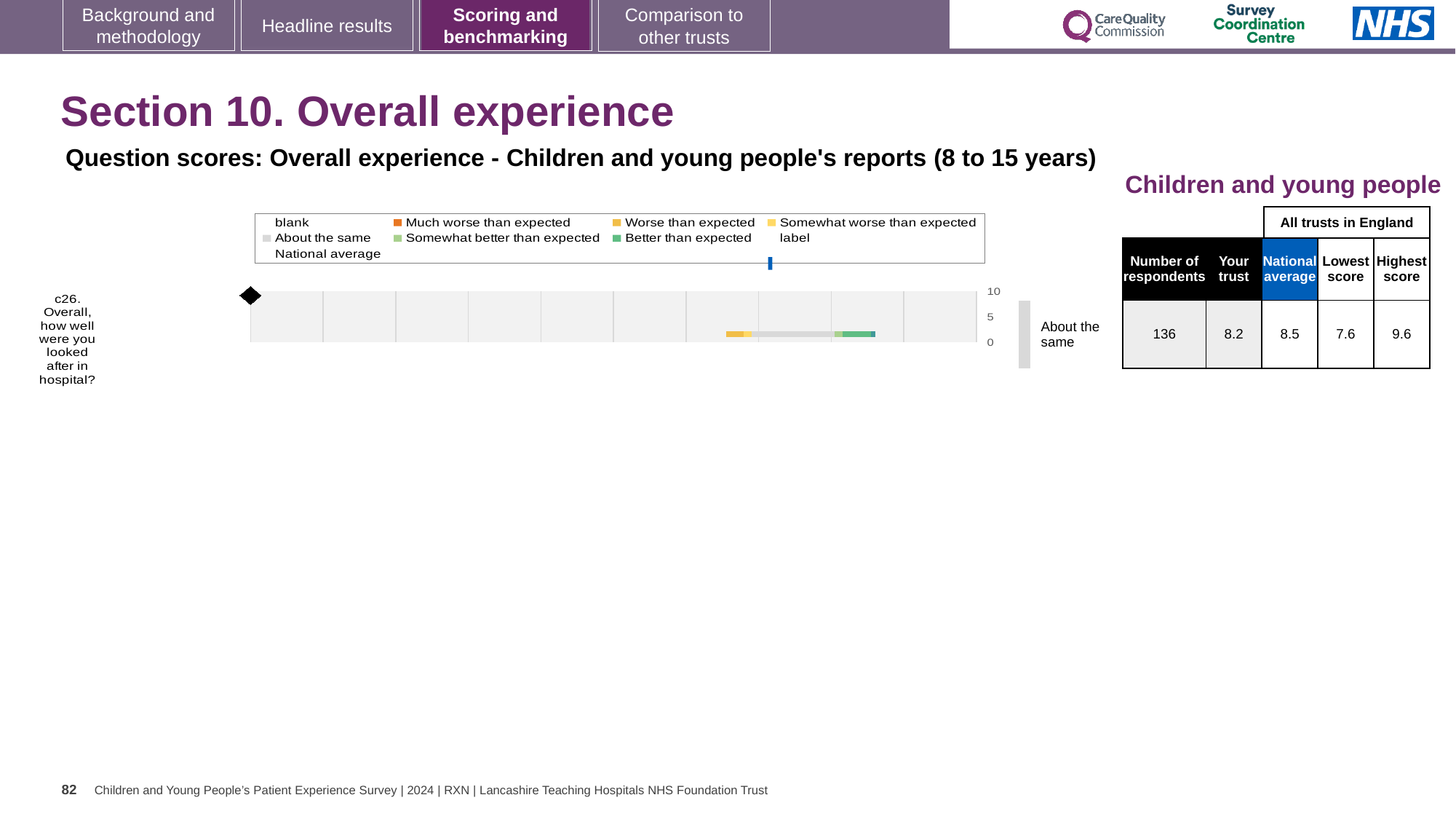
What is the maximum value shown on the chart's score axis? 10 What is the difference between the national average and the 'Your trust' score for question c26? 0.3 What kind of chart is used to show the score for question c26? bar chart What is the difference between the highest and lowest scores for question c26? 2.0 How many respondents answered question c26? 136 What benchmark category is shown next to the bar for question c26? About the same Which is larger for question c26: the 'Your trust' score or the national average? National average How many survey questions are plotted in the chart? 1 What is the 'Your trust' score for question c26, 'Overall, how well were you looked after in hospital?' 8.2 What is the highest score among all trusts in England for question c26? 9.6 What is the lowest score among all trusts in England for question c26? 7.6 What is the national average score for question c26? 8.5